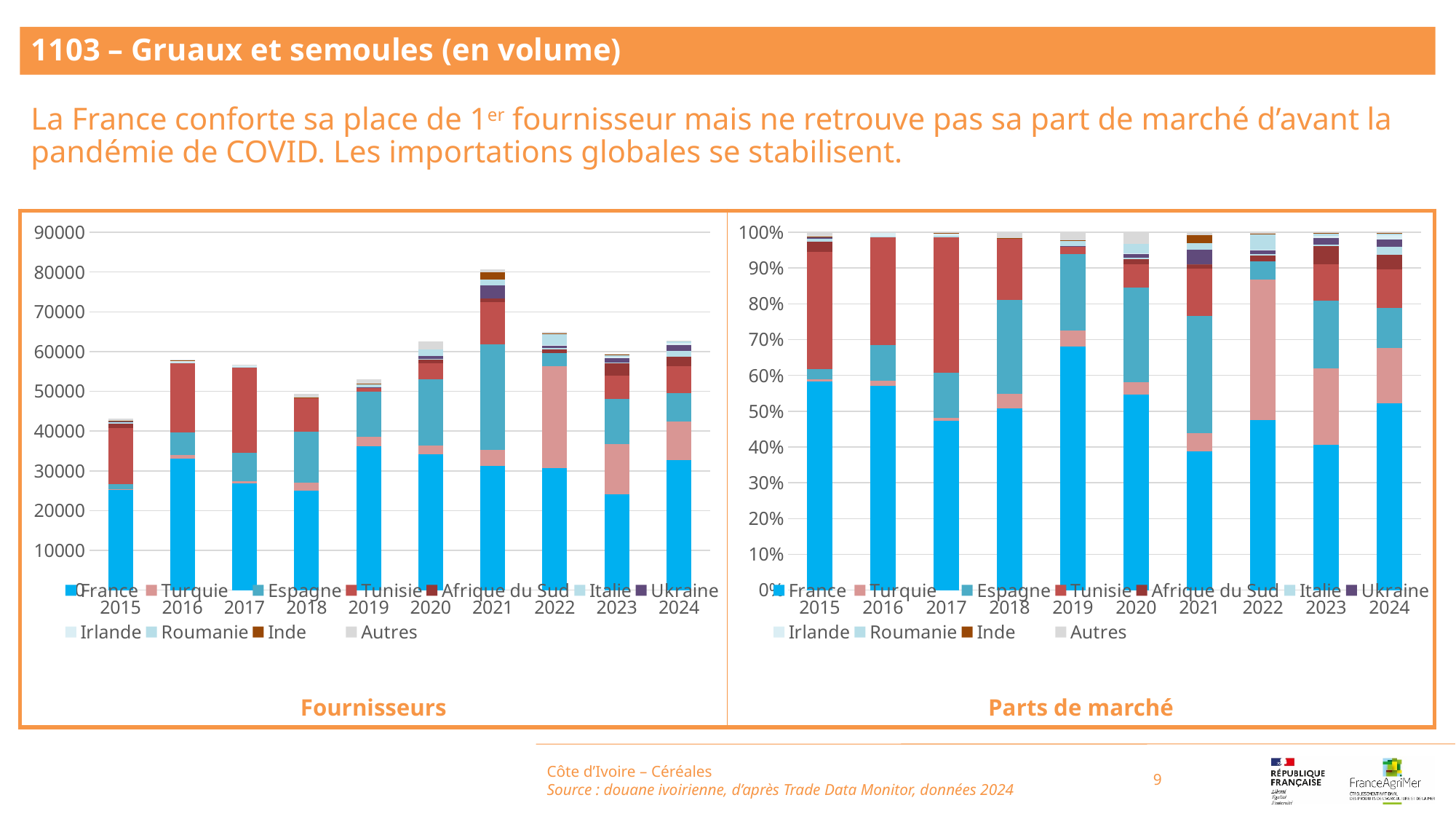
How many series does the legend of the 'Fournisseurs' chart list? 11 How many years are shown on the x axis of the 'Parts de marché' chart? 10 In the 'Fournisseurs' chart, which year has the tallest total bar? 2021 In the 'Parts de marché' chart, does the share for France rise or fall from 2017 to 2019? rise In the 'Parts de marché' chart, is the share for France in 2023 greater or less than 50%? less In the 'Fournisseurs' chart, which total bar is taller, 2021 or 2022? 2021 In the 'Fournisseurs' chart, which year has the shortest total bar? 2015 In the 'Fournisseurs' chart, is the total for 2015 greater or less than 50000? less In the 'Parts de marché' chart, is the share for France in 2019 greater or less than 60%? greater What kind of chart is the 'Fournisseurs' chart on the left? Stacked bar chart Which series is shown at the bottom of each stacked bar in both charts? France